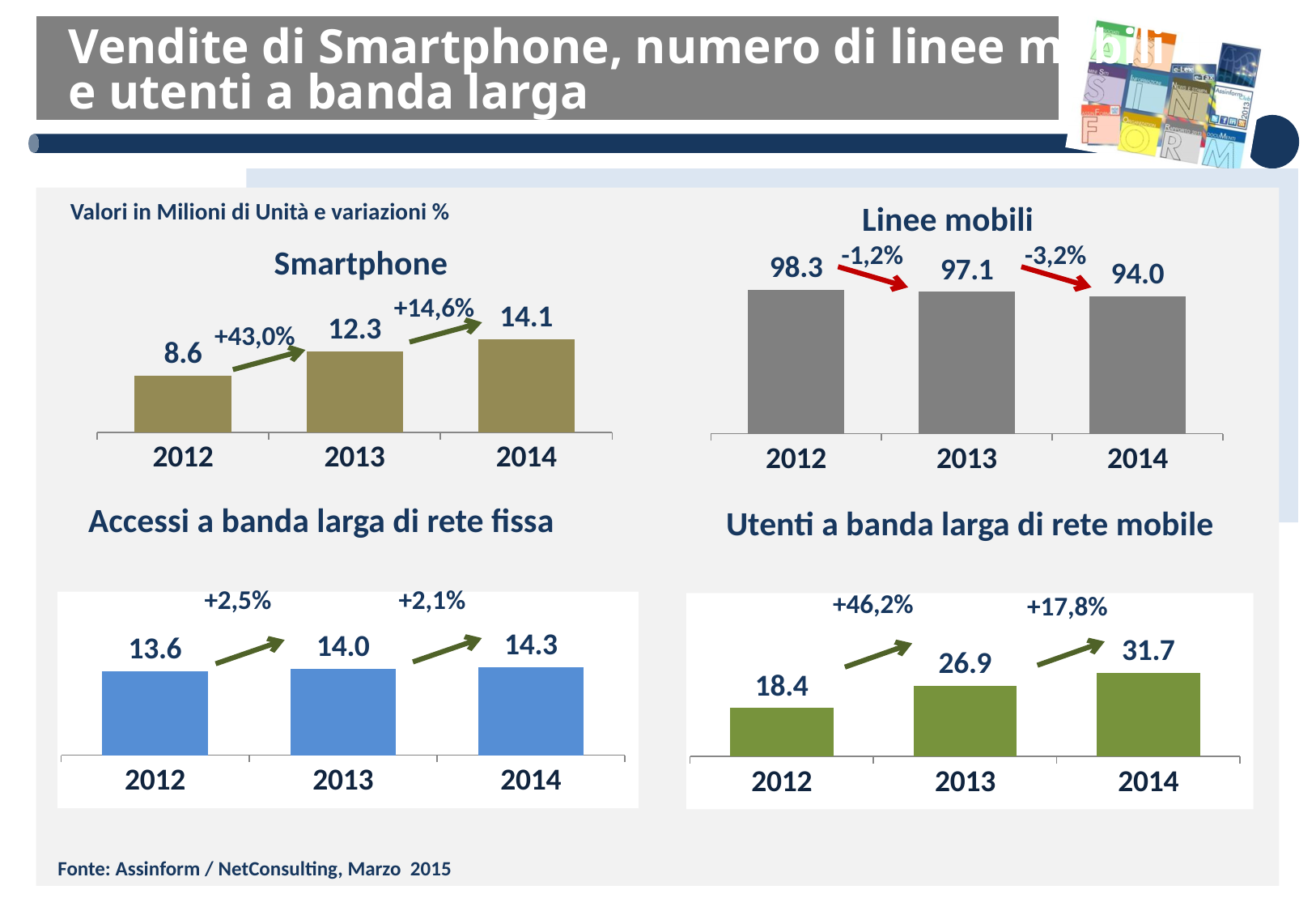
Do the values in the Linee mobili chart rise or fall from 2012 to 2014? fall In the Utenti a banda larga di rete mobile chart, what is the value for 2014? 31.7 What kind of chart is the Smartphone chart? bar chart In the Accessi a banda larga di rete fissa chart, what is the value for 2013? 14.0 How many years are shown in the Accessi a banda larga di rete fissa chart? 3 In the Linee mobili chart, what is the difference between the 2012 and 2014 values? 4.3 In the Utenti a banda larga di rete mobile chart, which year has the highest value? 2014 In the Utenti a banda larga di rete mobile chart, is the 2013 value larger or smaller than the 2012 value? larger In the Smartphone chart, what is the difference between the 2014 and 2012 values? 5.5 In the Linee mobili chart, which year has the lowest value? 2014 In the Linee mobili chart, what is the value for 2012? 98.3 In the Smartphone chart, what is the value for 2014? 14.1